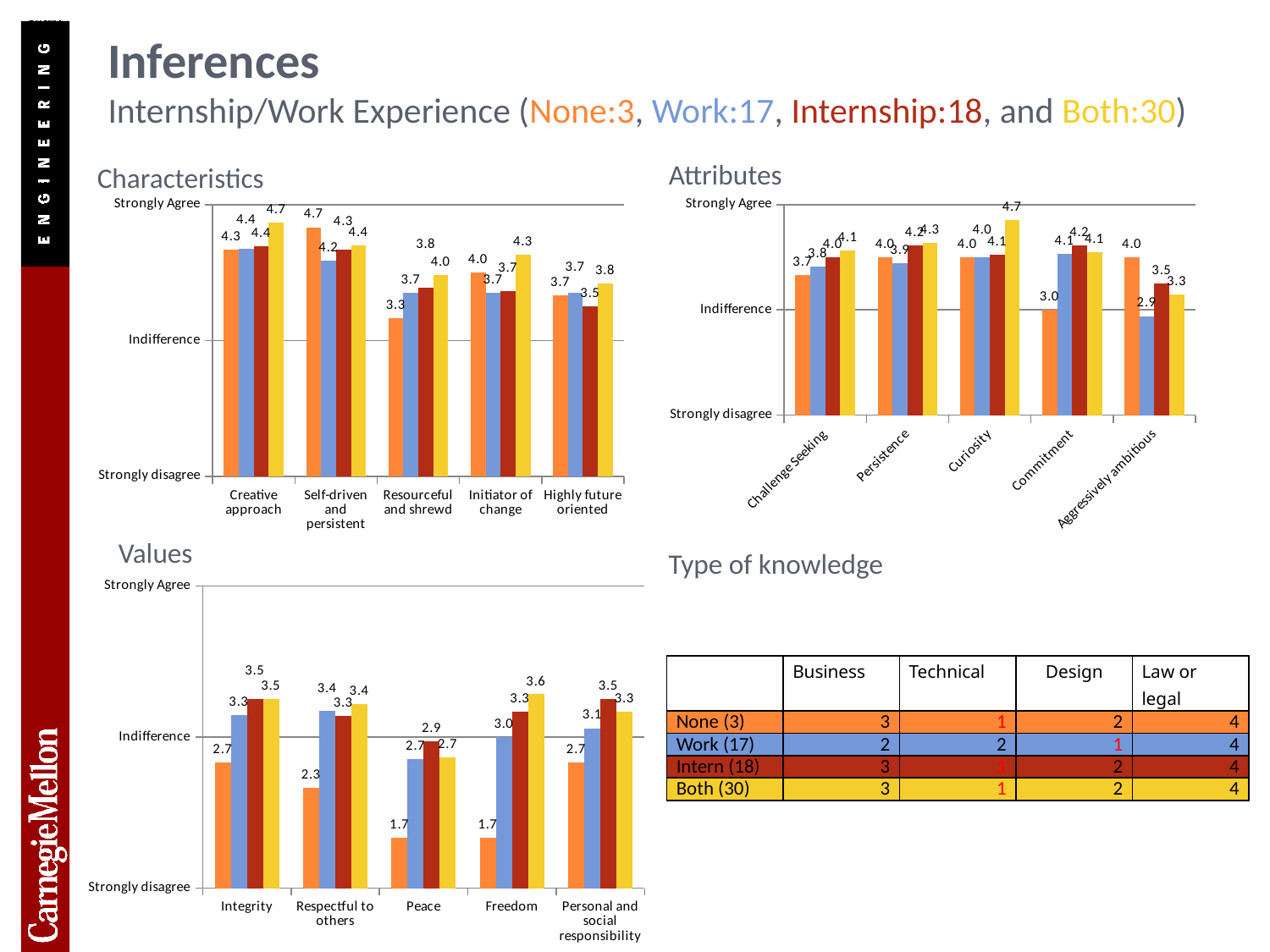
In the Attributes chart, what is the value for Commitment in the None (orange) series? 3.0 In the Attributes chart, which category has the lowest value in the Work (blue) series? Aggressively ambitious In the Values chart, which category has the lowest value in the None (orange) series? Peace and Freedom (both 1.7) In the Values chart, what is the value for Freedom in the Both (yellow) series? 3.6 In the Values chart, which is larger: the Internship (red) value for Integrity or the Internship (red) value for Peace? Integrity In the Attributes chart, what is the difference between the Both (yellow) value for Curiosity and the Both (yellow) value for Aggressively ambitious? 1.4 In the Characteristics chart, what is the value for Resourceful and shrewd in the None (orange) series? 3.3 How many categories are shown on the x axis of the Characteristics chart? 5 In the Characteristics chart, which category has the highest value in the None (orange) series? Self-driven and persistent In the Characteristics chart, what is the value for Creative approach in the Both (yellow) series? 4.7 What type of chart is the Values chart? Bar chart In the Attributes chart, what is the value for Curiosity in the Both (yellow) series? 4.7